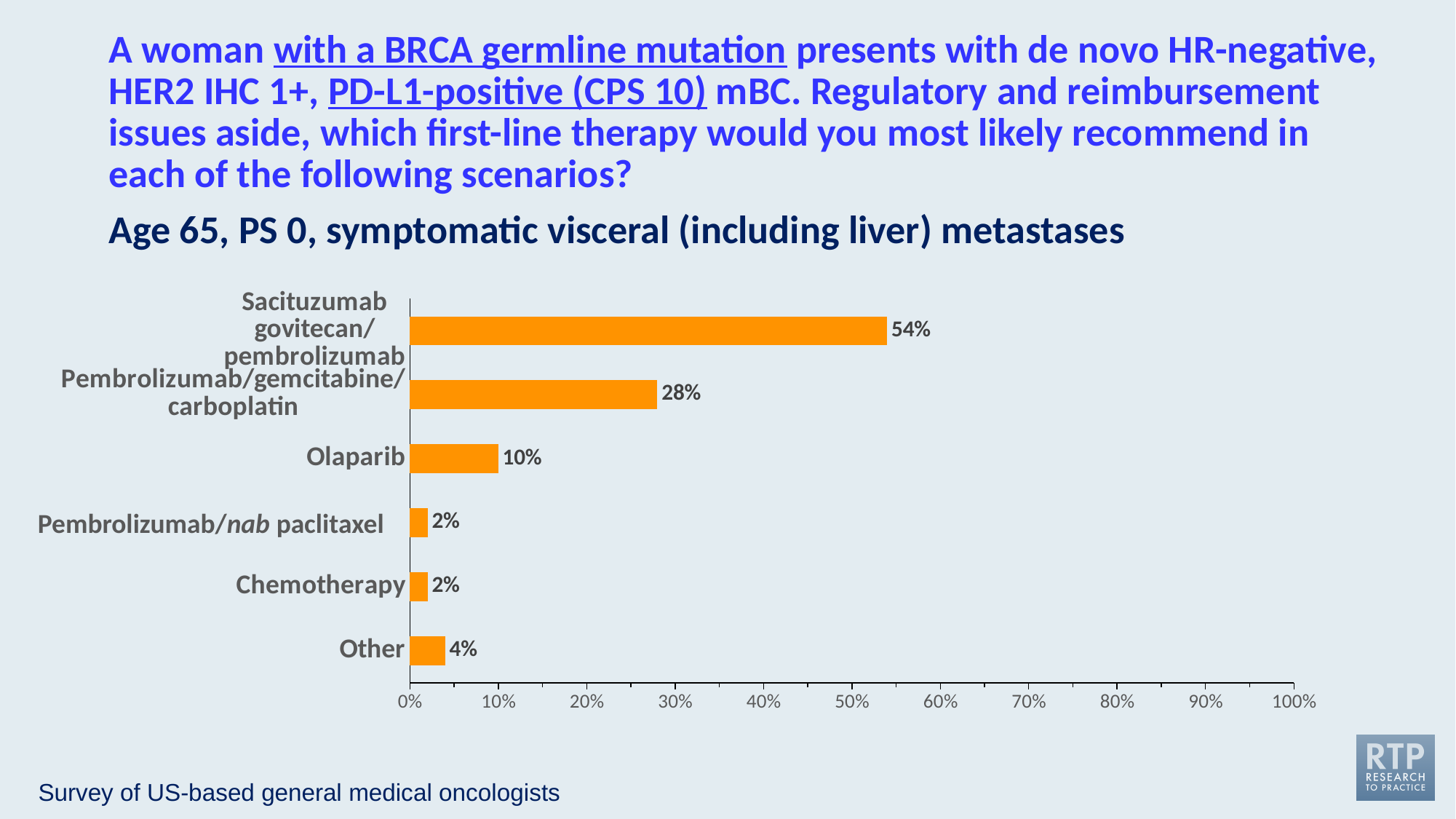
What percentage of respondents chose sacituzumab govitecan/pembrolizumab? 54% What is the value for pembrolizumab/gemcitabine/carboplatin? 28% Is the value for sacituzumab govitecan/pembrolizumab greater or less than 50%? greater What is the maximum value shown on the horizontal axis? 100% What kind of chart is shown on the slide? Bar chart What is the difference between the values for sacituzumab govitecan/pembrolizumab and pembrolizumab/gemcitabine/carboplatin? 26% What is the value for Other? 4% What is the difference between the values for olaparib and Other? 6% Which therapy option has the highest percentage? Sacituzumab govitecan/pembrolizumab Which is larger, the value for olaparib or the value for Other? Olaparib What percentage of respondents chose olaparib? 10% How many therapy options are shown in the chart? 6